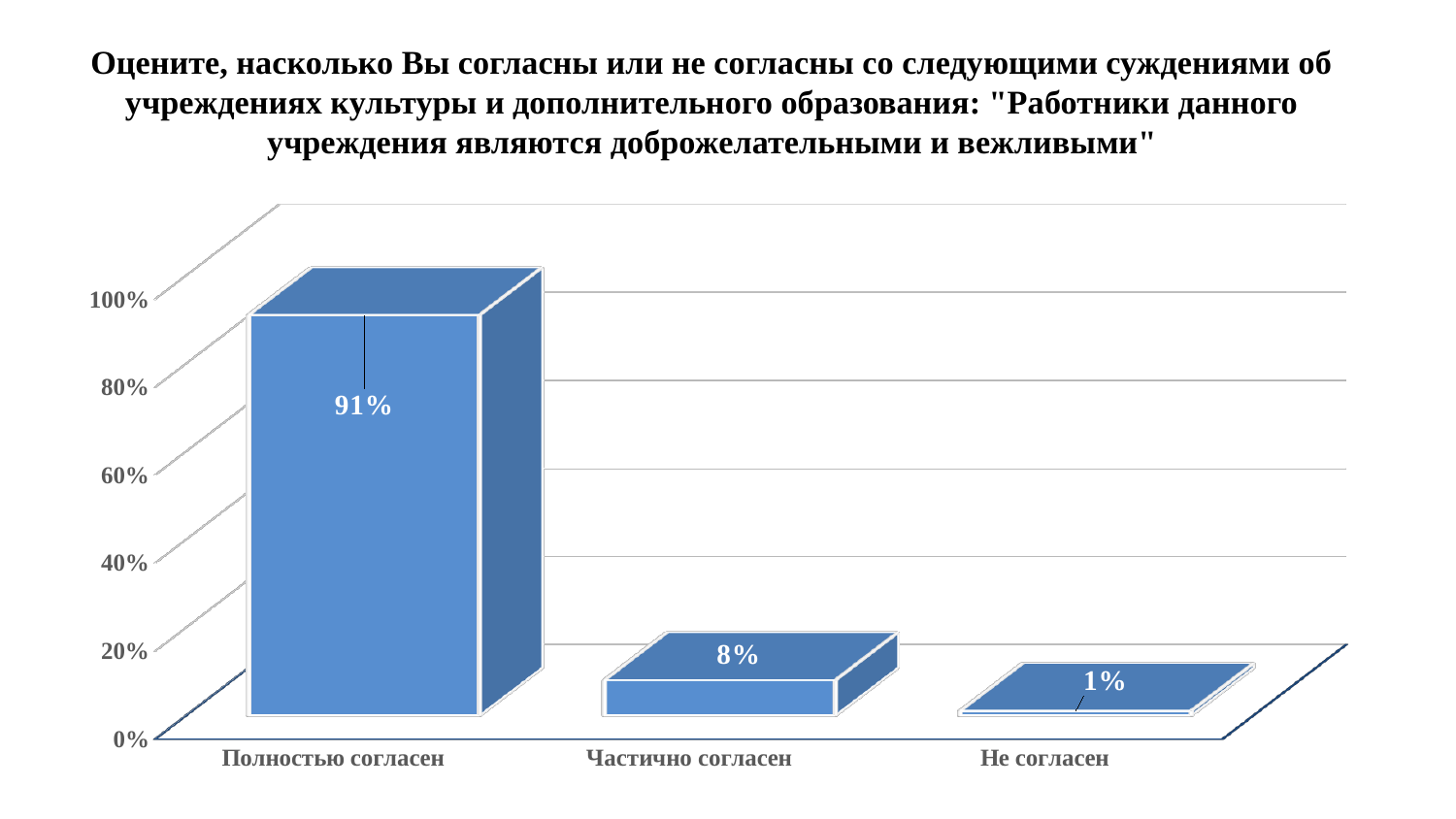
What kind of chart is shown on the slide? bar chart What is the value for "Полностью согласен"? 91% What is the value for "Частично согласен"? 8% What is the difference between the values for "Частично согласен" and "Не согласен"? 7% Which category has the lowest value? Не согласен Which category has the highest value? Полностью согласен Is the value for "Полностью согласен" greater or less than 80%? greater What is the difference between the values for "Полностью согласен" and "Частично согласен"? 83% Which is larger, the value for "Частично согласен" or the value for "Не согласен"? Частично согласен Do the values rise or fall from left to right along the x axis? fall What is the value for "Не согласен"? 1% How many categories are shown on the x axis? 3